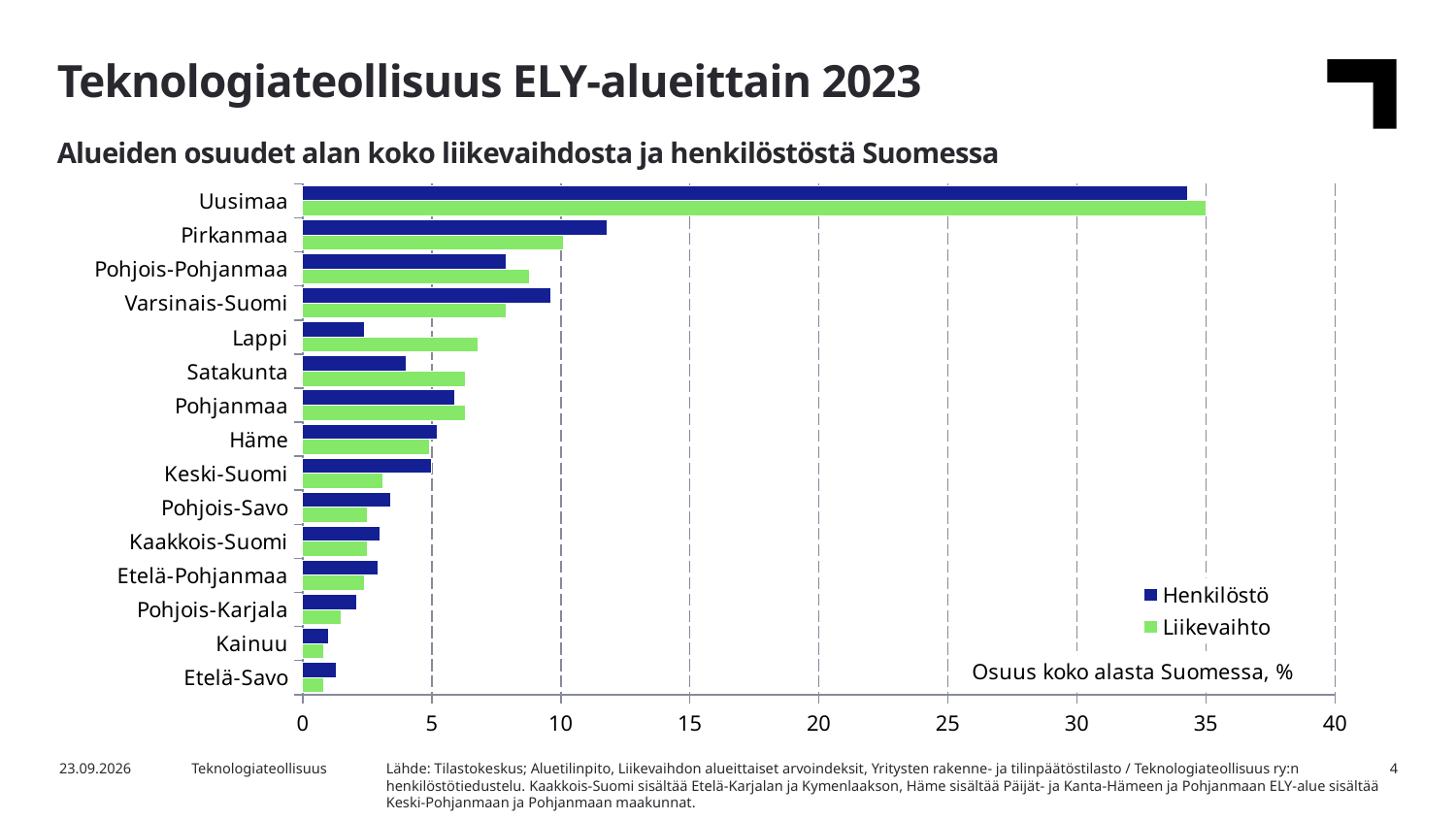
For Varsinais-Suomi, which is larger: Henkilöstö or Liikevaihto? Henkilöstö Which region has the highest Liikevaihto value? Uusimaa For Lappi, which is larger: Henkilöstö or Liikevaihto? Liikevaihto Is the Henkilöstö value for Lappi greater or less than 5? less Is the Liikevaihto value for Lappi greater or less than 5? greater What kind of chart is shown on the slide? Bar chart Is the Henkilöstö value for Uusimaa greater or less than 30? greater How many series does the legend list? 2 Which colour represents the Liikevaihto series? Green How many regions (categories) are shown on the chart? 15 Which region has the highest Henkilöstö value? Uusimaa